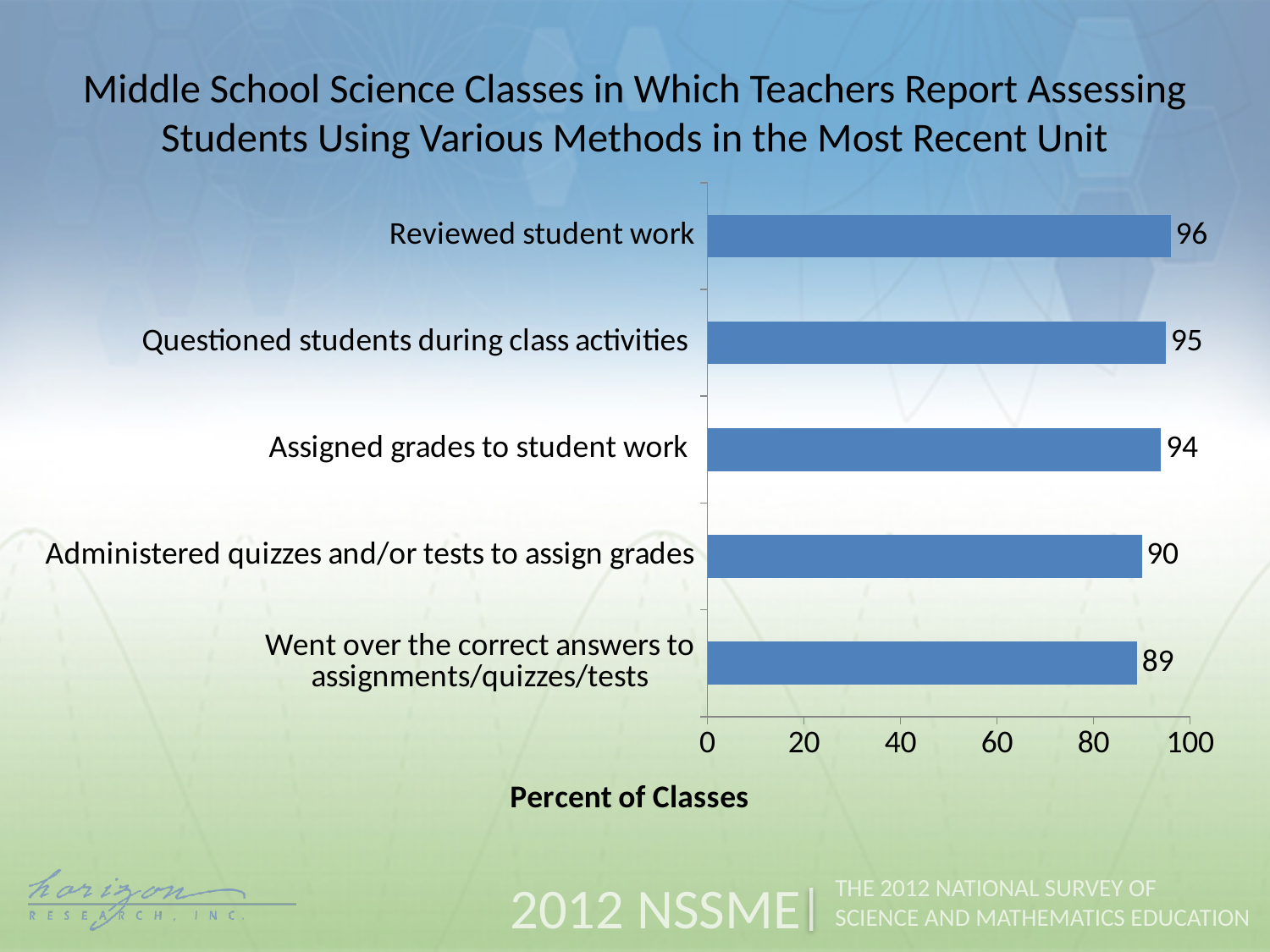
What percent of classes is shown for "Reviewed student work"? 96 Which assessment method has the highest percent of classes? Reviewed student work What is the value for "Went over the correct answers to assignments/quizzes/tests"? 89 Which is larger: the value for "Questioned students during class activities" or "Administered quizzes and/or tests to assign grades"? Questioned students during class activities What is the value for "Administered quizzes and/or tests to assign grades"? 90 What is the difference between the values for "Reviewed student work" and "Went over the correct answers to assignments/quizzes/tests"? 7 Which assessment method has the lowest percent of classes? Went over the correct answers to assignments/quizzes/tests What is the difference between the values for "Assigned grades to student work" and "Administered quizzes and/or tests to assign grades"? 4 Is the value for "Went over the correct answers to assignments/quizzes/tests" greater or less than 80? greater What kind of chart is shown on the slide? Bar chart What is the label of the horizontal axis? Percent of Classes How many assessment methods are shown in the chart? 5